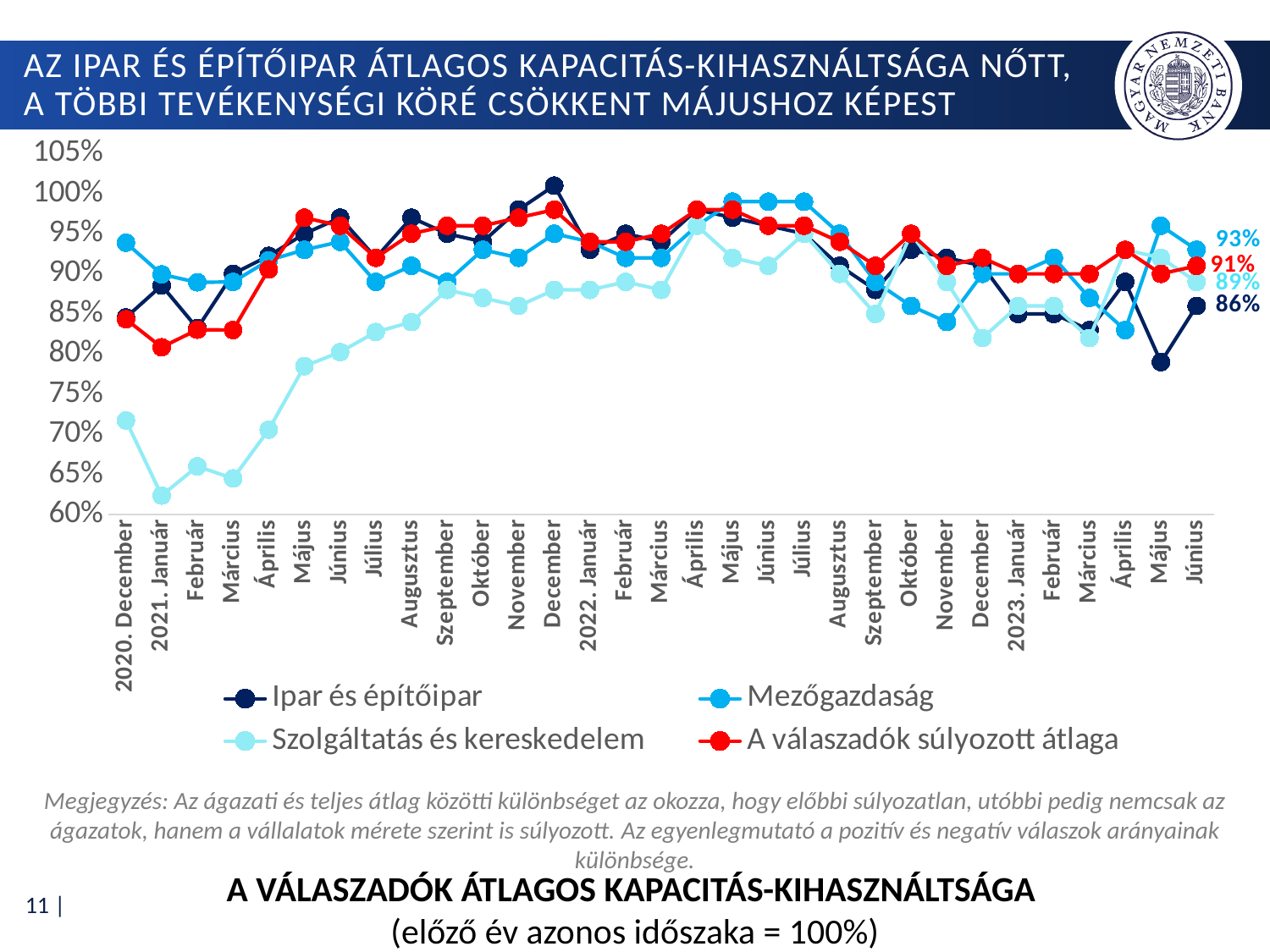
In 2023 Június, which is larger: Szolgáltatás és kereskedelem or Ipar és építőipar? Szolgáltatás és kereskedelem How many series does the legend list? 4 Does the Szolgáltatás és kereskedelem series rise or fall from 2021 Január to 2021 Szeptember? Rise What is the value for Szolgáltatás és kereskedelem in 2023 Június? 89% Is the value for Szolgáltatás és kereskedelem in 2021 Január greater or less than 65%? less Which series has the highest value in 2023 Június? Mezőgazdaság What is the difference between the Mezőgazdaság and Ipar és építőipar values in 2023 Június? 7 percentage points Which series has the lowest value in 2023 Június? Ipar és építőipar What is the value for Mezőgazdaság in 2023 Június? 93% What is the value for Ipar és építőipar in 2023 Június? 86% What kind of chart is shown on the slide? Line chart What is the value for A válaszadók súlyozott átlaga in 2023 Június? 91%